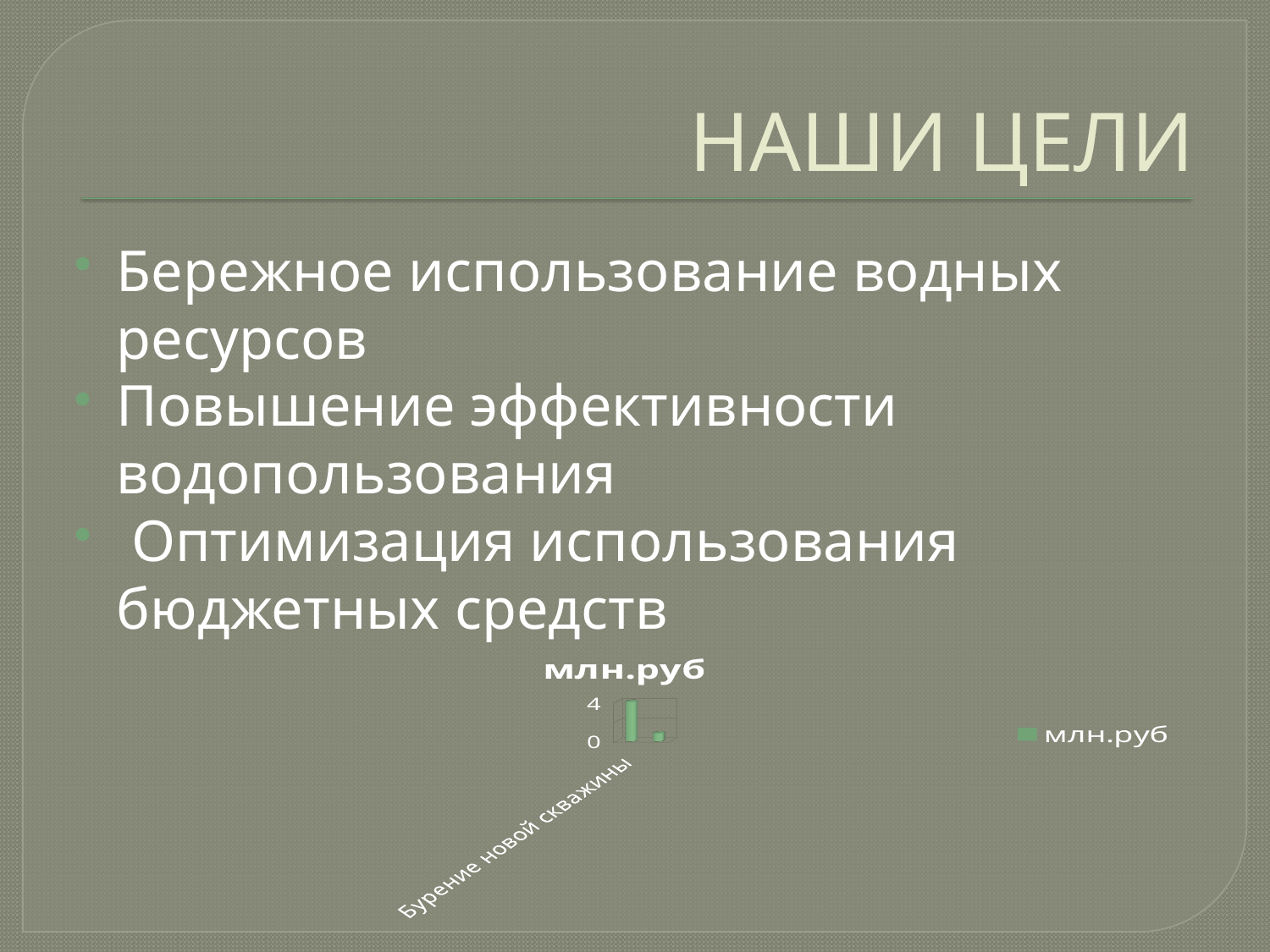
What is the legend entry of the chart? млн.руб Which category has the highest value in the chart? Бурение новой скважины What is the title of the chart on the slide? млн.руб Which bar is taller in the chart, the left one (Бурение новой скважины) or the right one? the left one (Бурение новой скважины) How many bars are plotted in the chart? 2 What is the highest value shown on the chart's vertical axis? 4 How many series does the chart's legend list? 1 What kind of chart is shown at the bottom of the slide? bar chart